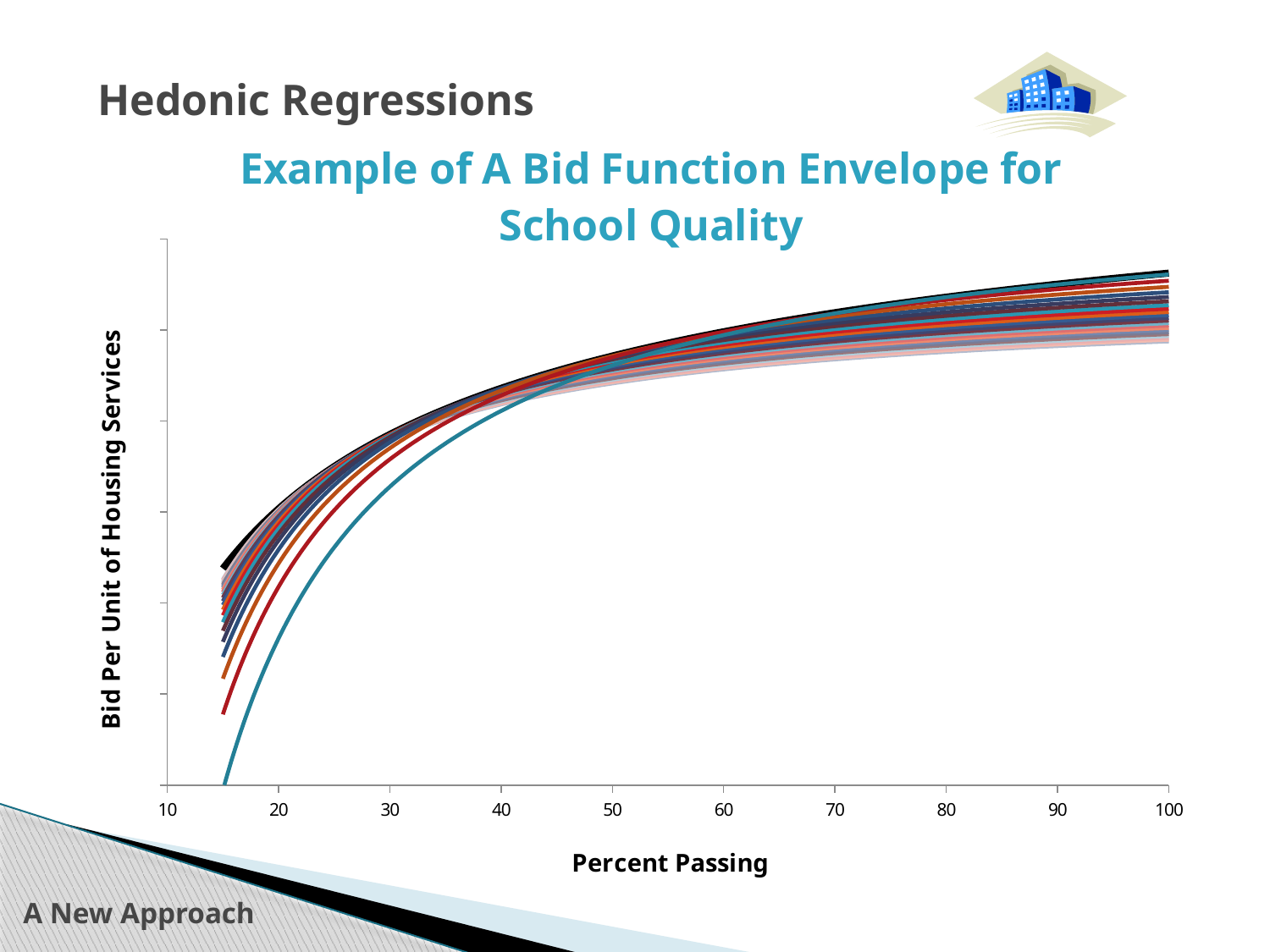
What is the title of the chart? Example of A Bid Function Envelope for School Quality Do the curves rise more steeply at low Percent Passing values or at high Percent Passing values? low What kind of chart is shown on the slide? line chart Do the curves rise or fall as Percent Passing increases from 10 to 100? rise What is the label on the x axis of the chart? Percent Passing